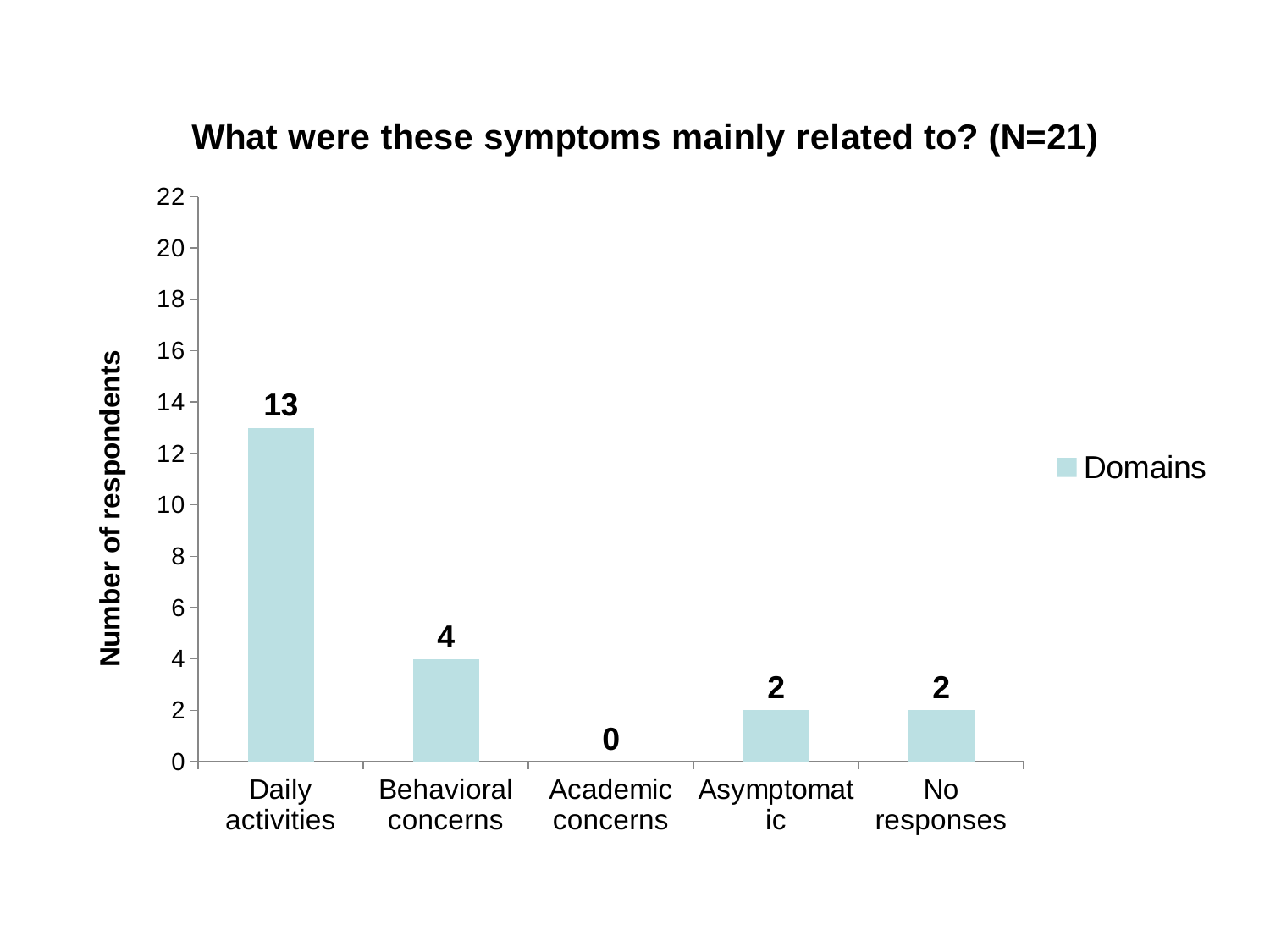
What kind of chart is shown on the slide? Bar chart What is the value for Behavioral concerns? 4 Is the value for Daily activities greater or less than 10? greater Which category has the lowest number of respondents? Academic concerns What is the value for Asymptomatic? 2 What is the label on the vertical axis? Number of respondents What is the value for Academic concerns? 0 How many respondents said their symptoms were mainly related to Daily activities? 13 Which is larger, the value for Behavioral concerns or the value for No responses? Behavioral concerns What is the difference between the values for Daily activities and Behavioral concerns? 9 How many categories are shown on the x axis? 5 Which category has the highest number of respondents? Daily activities